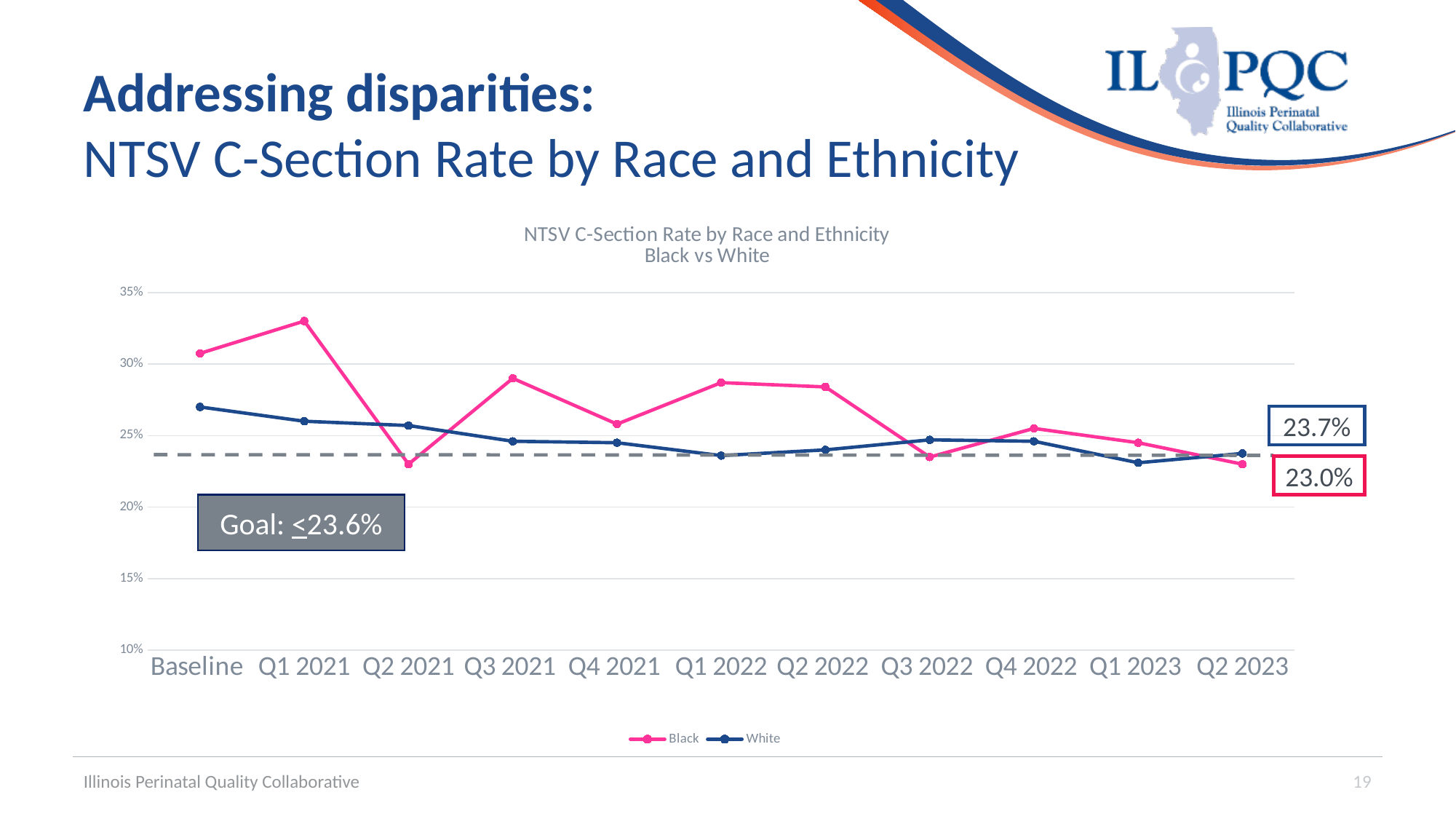
What type of chart is shown on the slide? line chart What goal value is shown in the box on the chart? ≤23.6% What is the difference between the White and Black rates in Q2 2023? 0.7% What is the NTSV C-section rate for White patients in Q2 2023? 23.7% At which time point is the White series highest? Baseline Does the Black series overall rise or fall from Baseline to Q2 2023? fall Which series has the larger value at Q2 2021, Black or White? White Is the value for Black in Q1 2021 greater or less than 30%? greater At which time point is the Black series highest? Q1 2021 What is the NTSV C-section rate for Black patients in Q2 2023? 23.0% How many series does the legend list? 2 How many time points are plotted along the x axis? 11